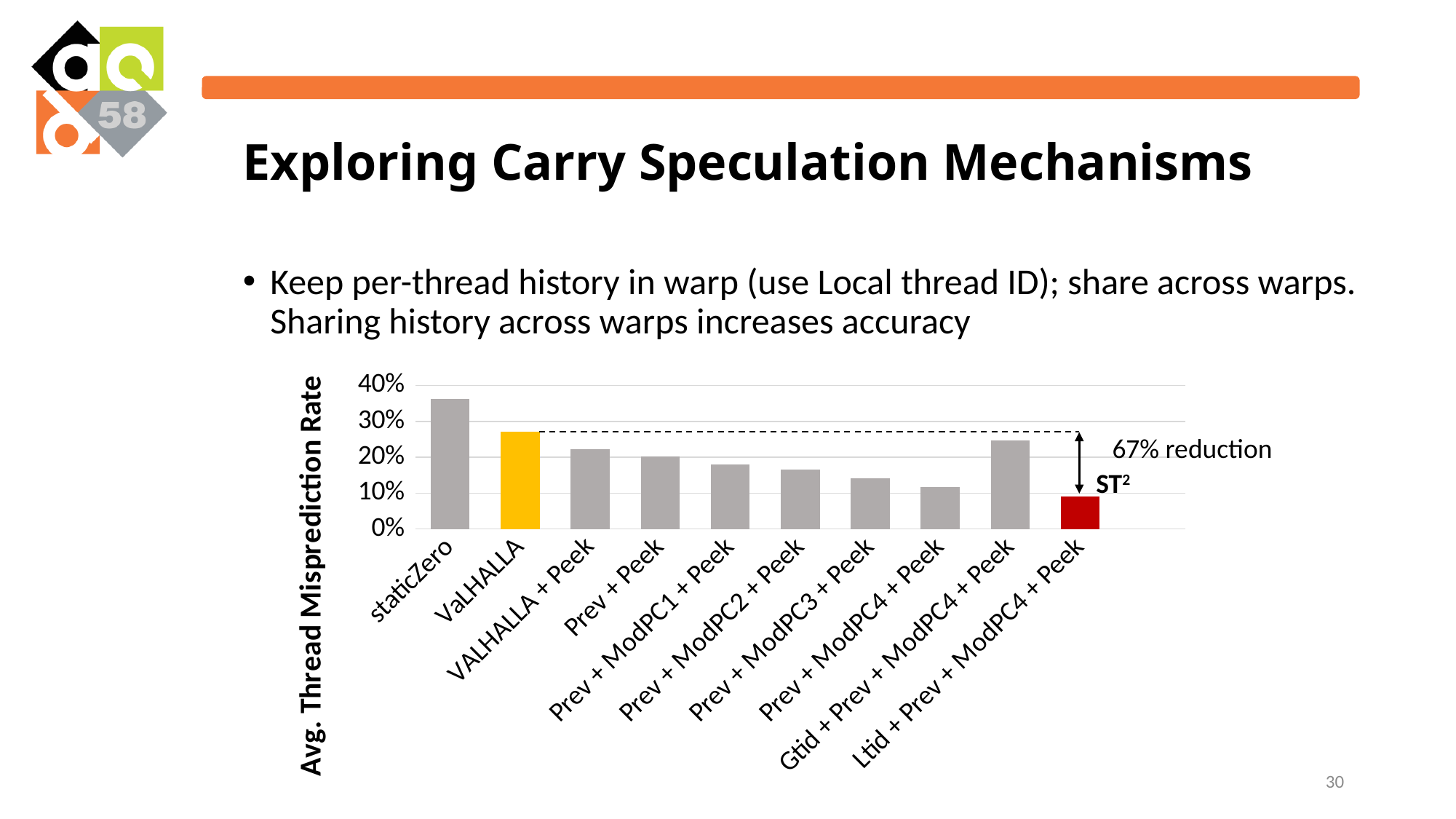
What is the label of the y axis of the chart? Avg. Thread Misprediction Rate What kind of chart is shown on the slide? bar chart Is the value for staticZero greater or less than 30%? greater Is the value for Ltid + Prev + ModPC4 + Peek greater or less than 10%? less Which category has the highest average thread misprediction rate? staticZero Is the value for Prev + ModPC3 + Peek greater or less than 20%? less What reduction does the annotation next to the arrow on the chart state? 67% reduction Which category has the lowest average thread misprediction rate? Ltid + Prev + ModPC4 + Peek How many categories are plotted on the x axis of the chart? 10 Which has a higher misprediction rate, Gtid + Prev + ModPC4 + Peek or Ltid + Prev + ModPC4 + Peek? Gtid + Prev + ModPC4 + Peek